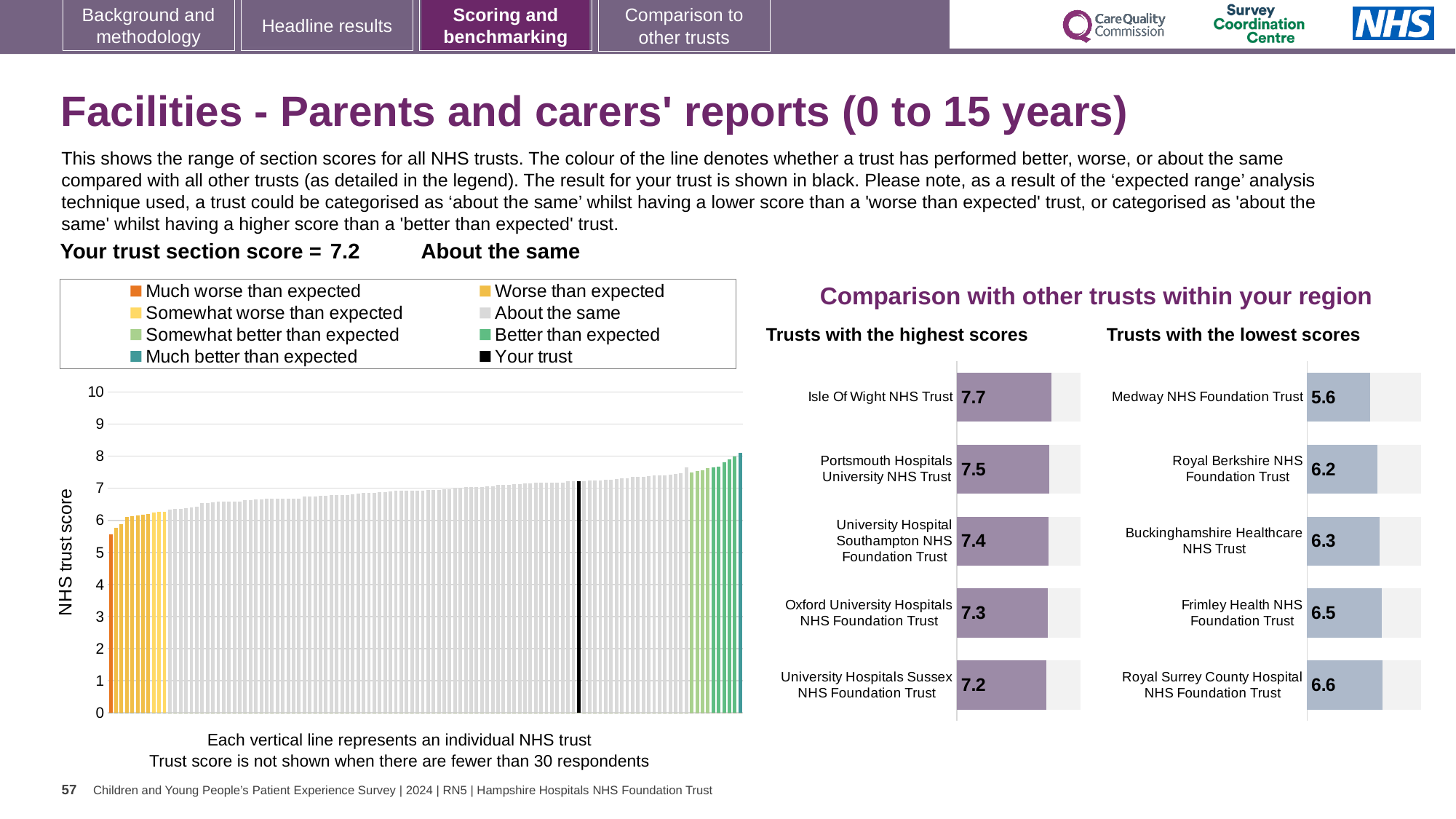
In the 'Trusts with the lowest scores' chart, what is the score for Medway NHS Foundation Trust? 5.6 In the main 'NHS trust score' chart on the left, what is the section score for your trust (the black line)? 7.2 In the 'Trusts with the highest scores' chart, what is the score for Isle Of Wight NHS Trust? 7.7 How many trusts are listed in the 'Trusts with the highest scores' chart? 5 In the 'Trusts with the highest scores' chart, which trust has the lowest score shown? University Hospitals Sussex NHS Foundation Trust In the 'Trusts with the highest scores' chart, what is the score for Oxford University Hospitals NHS Foundation Trust? 7.3 In the 'Trusts with the lowest scores' chart, which trust has the highest score shown? Royal Surrey County Hospital NHS Foundation Trust In the 'Trusts with the lowest scores' chart, what is the difference between the scores of Frimley Health NHS Foundation Trust and Royal Berkshire NHS Foundation Trust? 0.3 In the 'Trusts with the lowest scores' chart, which has the larger score: Buckinghamshire Healthcare NHS Trust or Medway NHS Foundation Trust? Buckinghamshire Healthcare NHS Trust In the main 'NHS trust score' chart on the left, is the value of the leftmost (orange) bar greater or less than 6? less In the 'Trusts with the highest scores' chart, what is the difference between the scores of Isle Of Wight NHS Trust and Portsmouth Hospitals University NHS Trust? 0.2 How many entries does the legend of the main 'NHS trust score' chart on the left list? 8